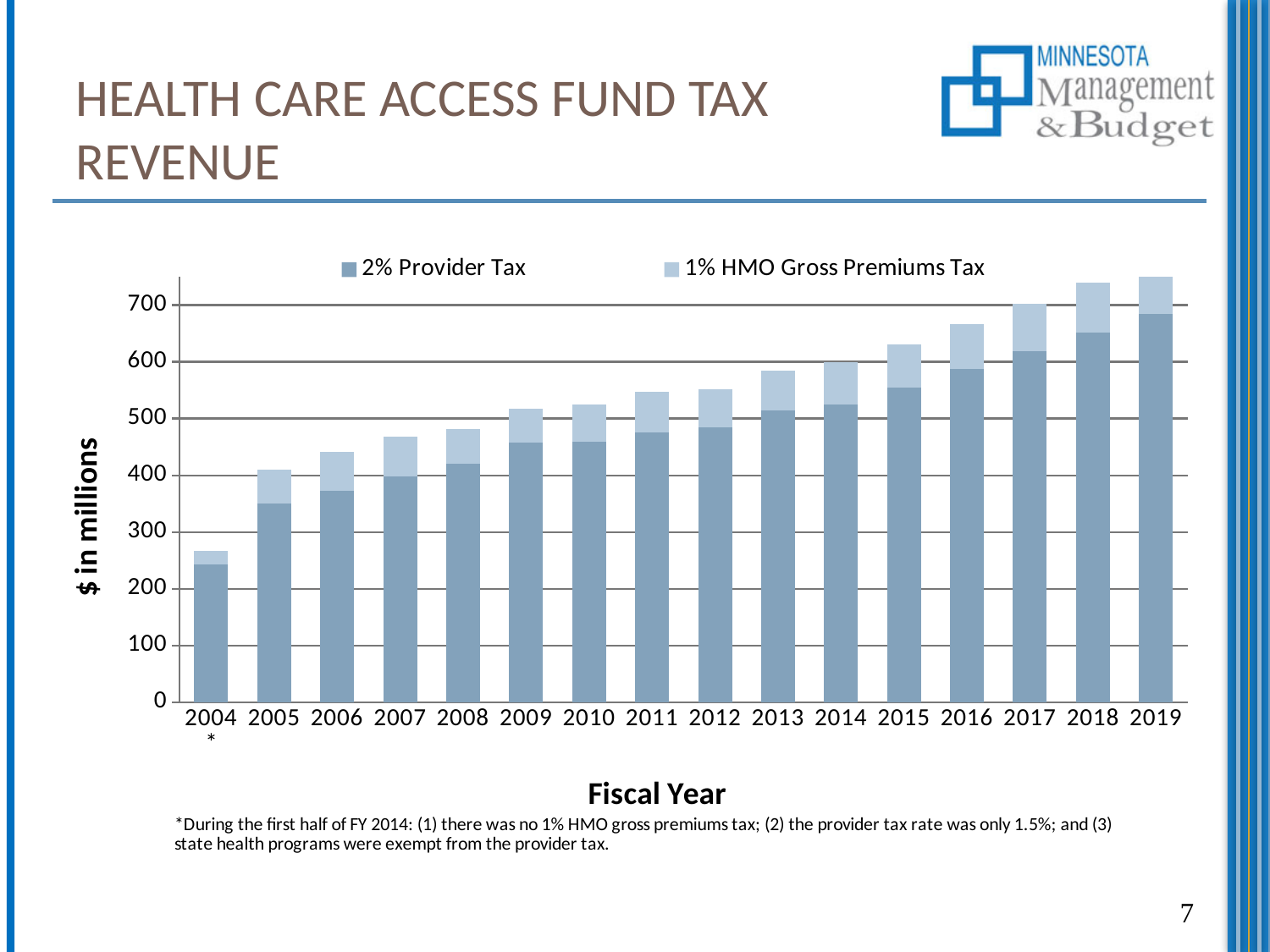
What is the label on the y axis? $ in millions How many fiscal years are shown on the x axis? 16 Which is larger, the total tax revenue for 2010 or for 2015? 2015 Is the total tax revenue for 2019 greater or less than 700? greater What kind of chart is shown on the slide? bar chart Is the 2% Provider Tax value for 2005 greater or less than 400? less Which fiscal year has the highest total tax revenue? 2019 How many series does the legend list? 2 Is the 2% Provider Tax value for 2018 greater or less than 600? greater Do total tax revenues generally rise or fall from 2004 to 2019? rise Which fiscal year has the lowest total tax revenue? 2004